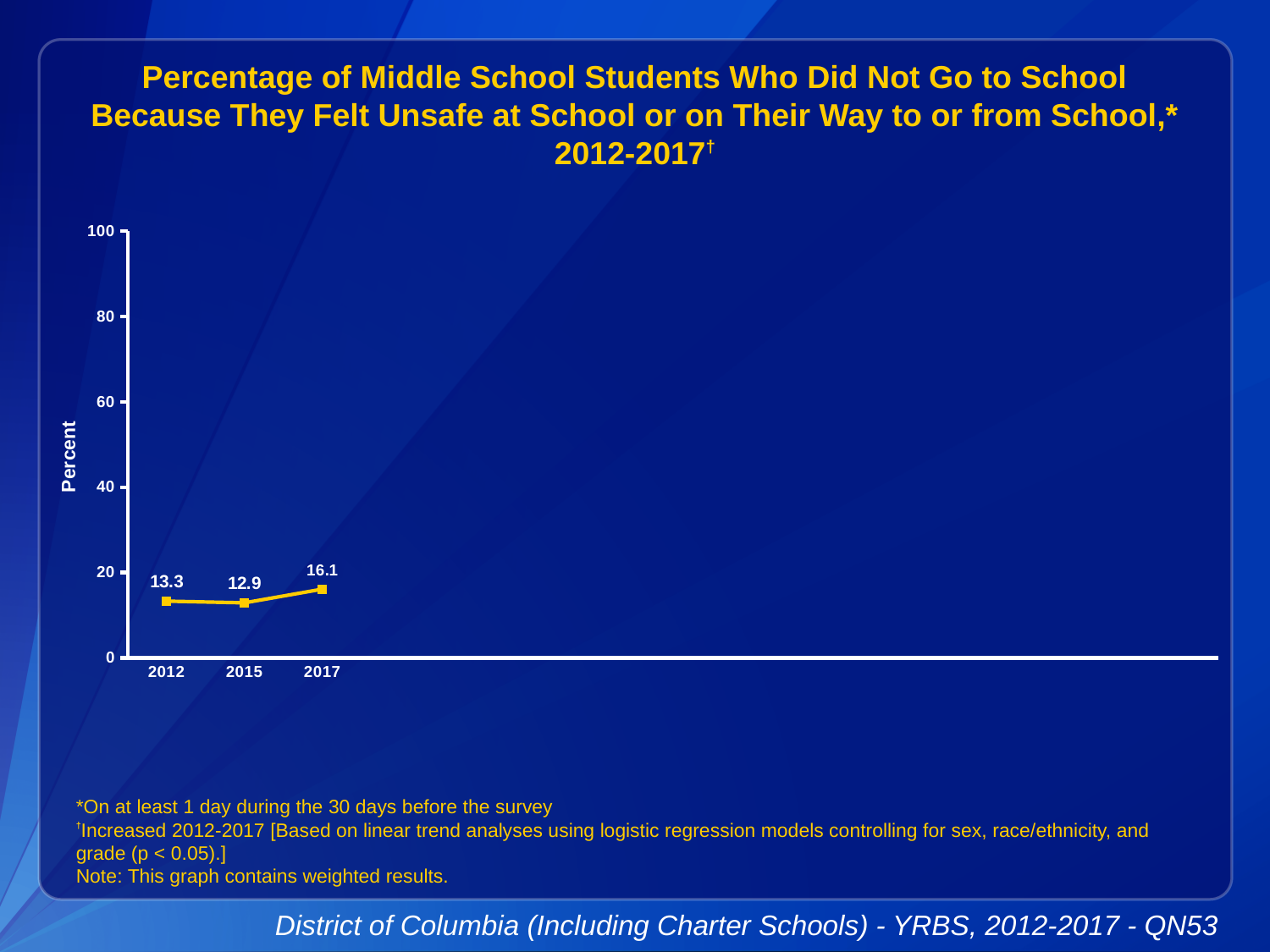
What kind of chart is shown on the slide? line chart What is the value for 2015? 12.9 Which year has the highest value? 2017 Which is larger, the value for 2017 or the value for 2015? 2017 Is the value for 2017 greater or less than 20? less What is the difference between the values for 2017 and 2012? 2.8 What is the value for 2012? 13.3 How many data points are plotted on the chart? 3 What is the label of the y axis? Percent Which year has the lowest value? 2015 What is the difference between the values for 2012 and 2015? 0.4 What is the value for 2017? 16.1